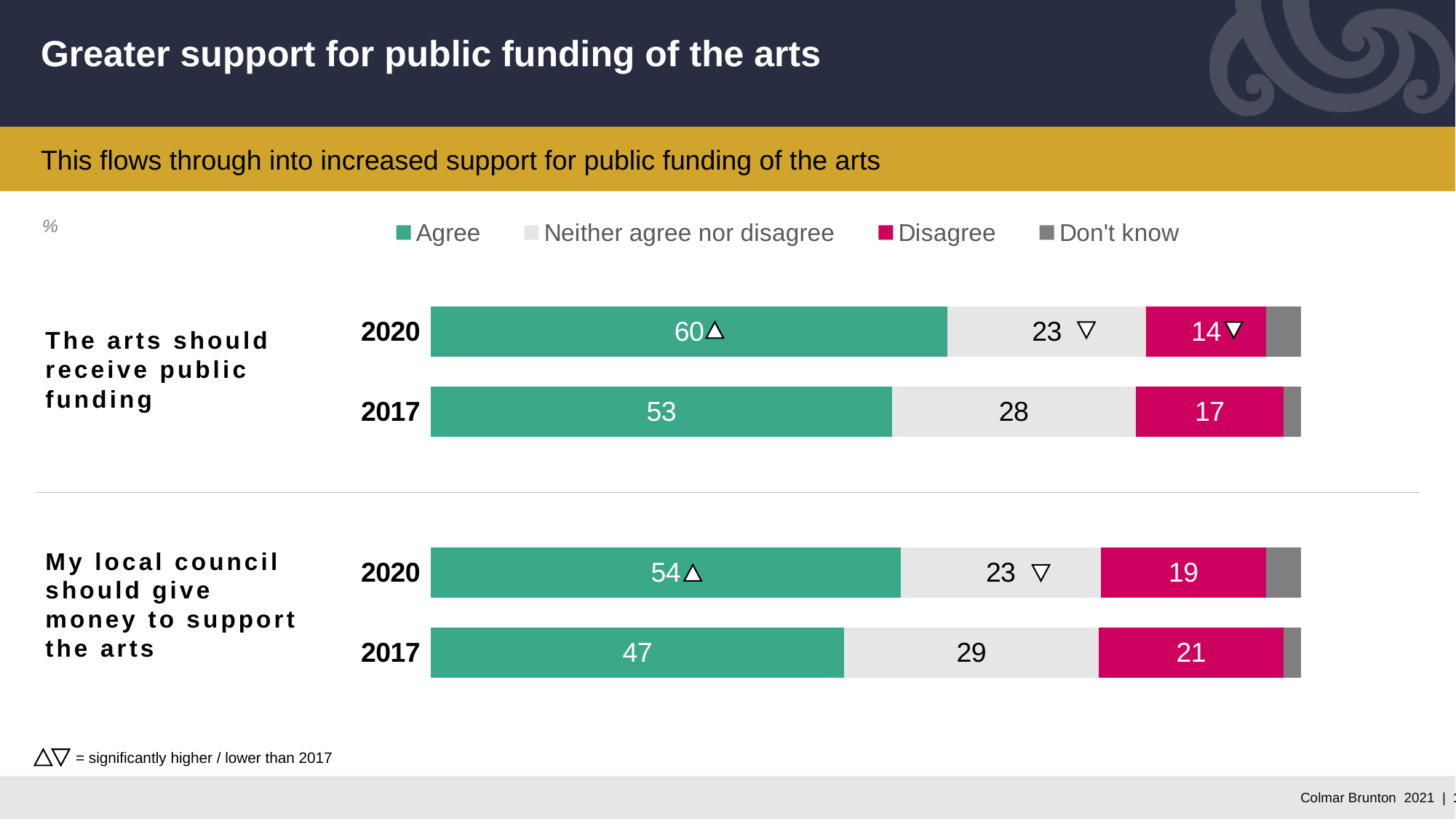
Which colour represents the Disagree series in the legend? Magenta/pink How many series does the legend list? 4 In the chart for 'The arts should receive public funding', by how many percentage points did the Agree value rise from 2017 to 2020? 7 In the chart for 'My local council should give money to support the arts', what percentage neither agreed nor disagreed in 2017? 29 What kind of chart is used on this slide? Stacked bar chart In the chart for 'The arts should receive public funding', which year has the larger Neither agree nor disagree value, 2020 or 2017? 2017 In the chart for 'The arts should receive public funding', what percentage agreed in 2020? 60 In the chart for 'The arts should receive public funding', what percentage disagreed in 2017? 17 In the chart for 'The arts should receive public funding', which response category has the lowest labelled value in 2020? Disagree In the chart for 'My local council should give money to support the arts', what percentage agreed in 2020? 54 In the chart for 'My local council should give money to support the arts', what is the difference between the Disagree values for 2017 and 2020? 2 In the chart for 'My local council should give money to support the arts', which year has the higher Agree value? 2020